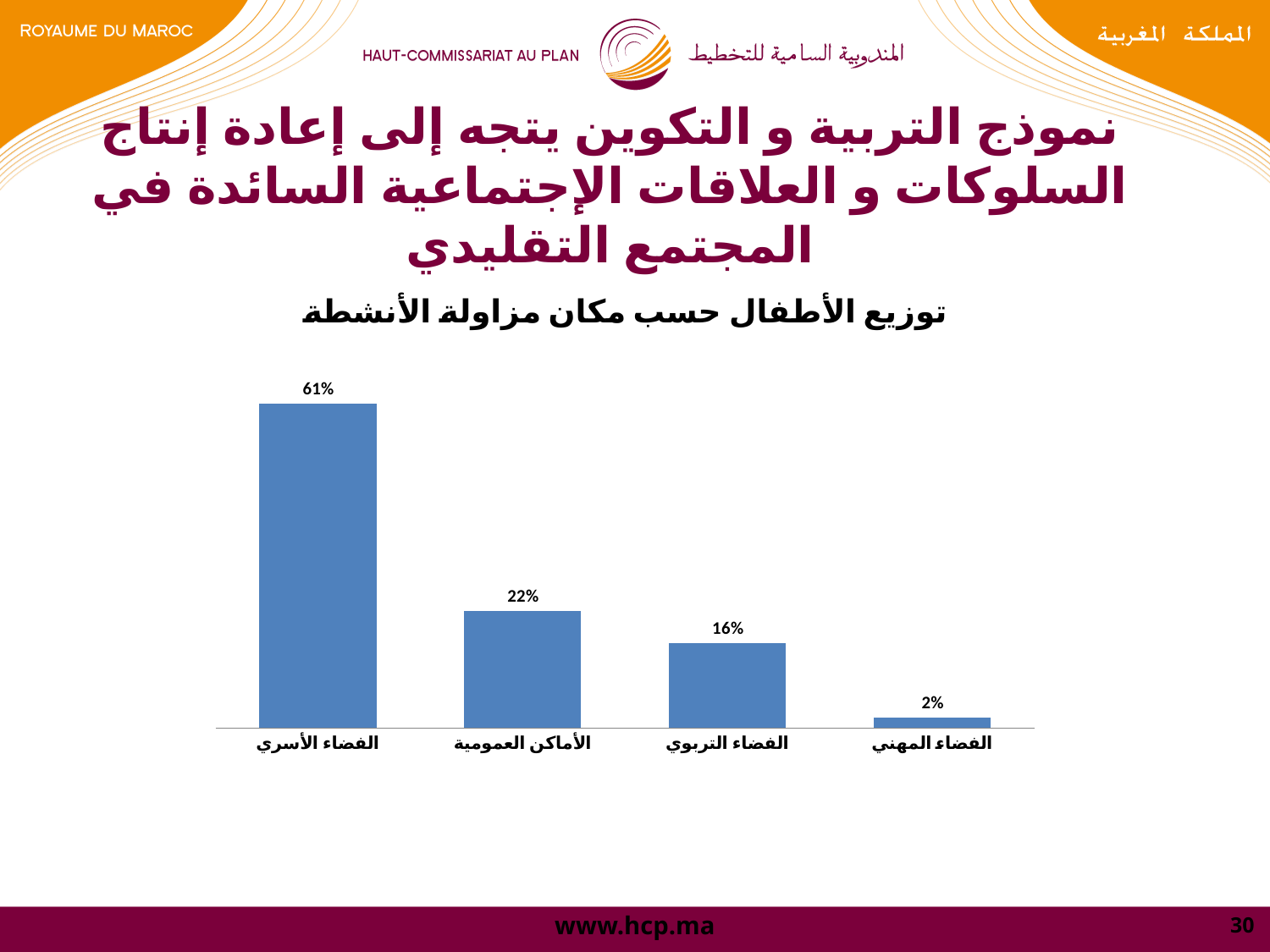
What is the title of the chart? توزيع الأطفال حسب مكان مزاولة الأنشطة Which category has the highest value? الفضاء الأسري What is the difference between the values for الفضاء التربوي and الفضاء المهني? 14% What is the value for الفضاء التربوي? 16% What is the difference between the values for الفضاء الأسري and الأماكن العمومية? 39% What is the value for الفضاء المهني? 2% What kind of chart is shown on the slide? bar chart How many categories are shown in the chart? 4 Which category has the lowest value? الفضاء المهني What is the value for الأماكن العمومية? 22% What is the value for الفضاء الأسري? 61% Which is larger, the value for الأماكن العمومية or the value for الفضاء التربوي? الأماكن العمومية